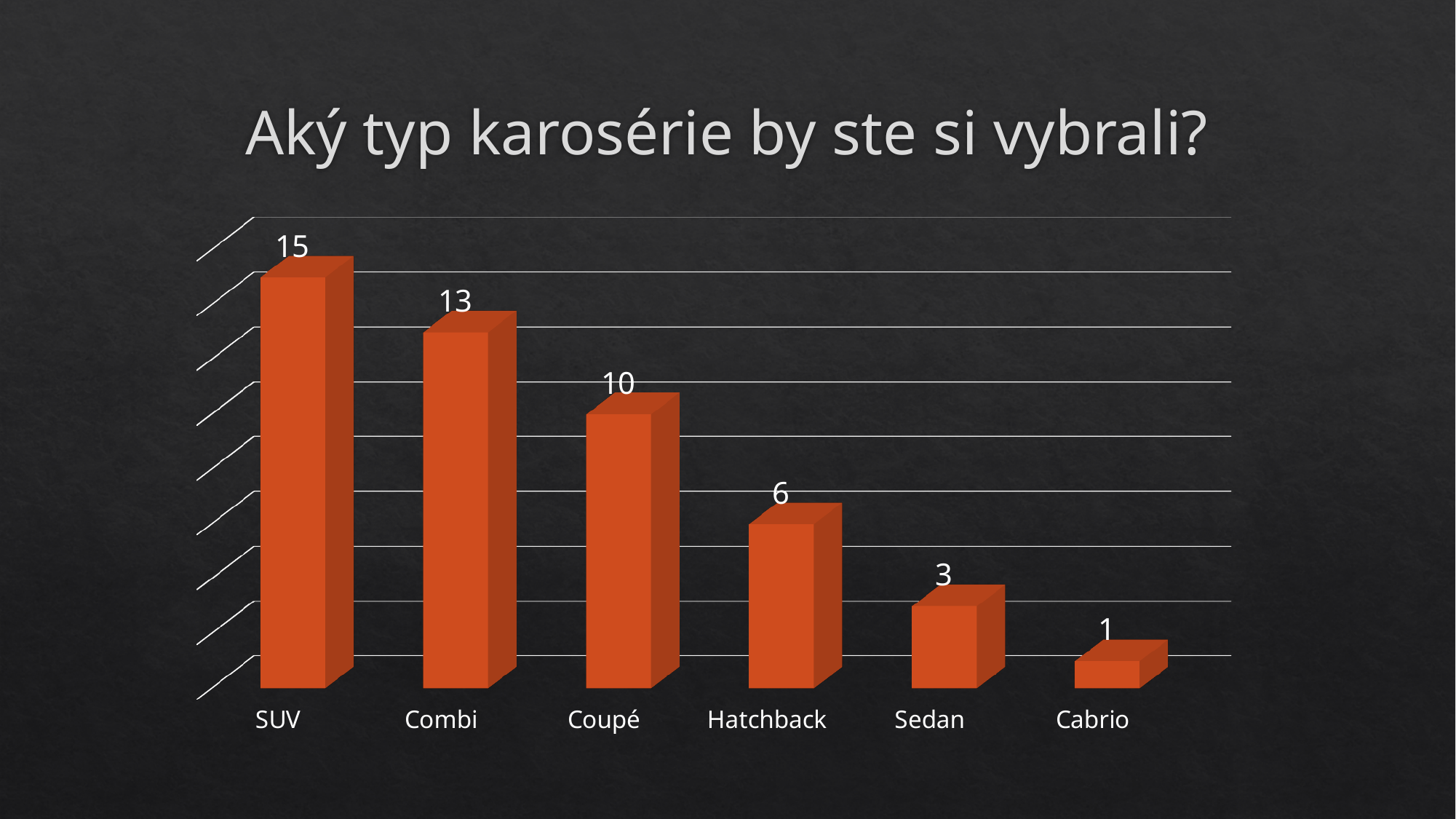
What is the value for Combi? 13 How many categories are shown on the x axis? 6 What kind of chart is shown on the slide? Bar chart What is the value for Cabrio? 1 Which category has the lowest value? Cabrio What is the value for SUV? 15 Which category has the highest value? SUV What is the difference between the values for SUV and Coupé? 5 Which is larger, the value for Combi or the value for Coupé? Combi What is the difference between the values for Hatchback and Sedan? 3 What is the value for Hatchback? 6 What is the title of the chart? Aký typ karosérie by ste si vybrali?